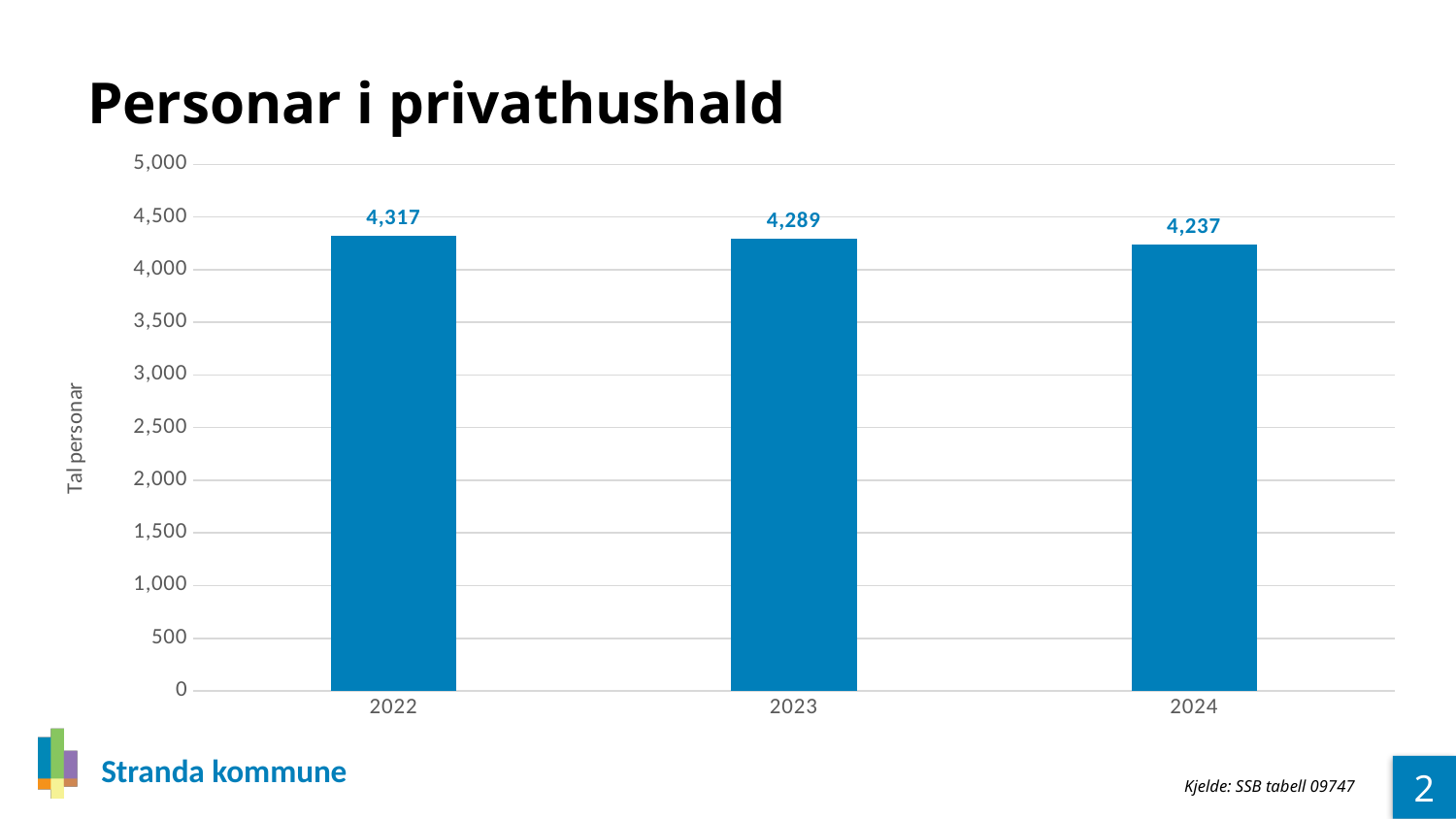
Do the values rise or fall from 2022 to 2024? fall What kind of chart is shown on the slide? bar chart What is the value for 2024? 4,237 Is the value for 2024 greater or less than 4,000? greater How many years are shown on the x axis? 3 What is the value for 2022? 4,317 Which is larger, the value for 2023 or the value for 2024? 2023 What is the difference between the values for 2022 and 2023? 28 What is the value for 2023? 4,289 What is the difference between the values for 2022 and 2024? 80 Which year has the highest value? 2022 Which year has the lowest value? 2024